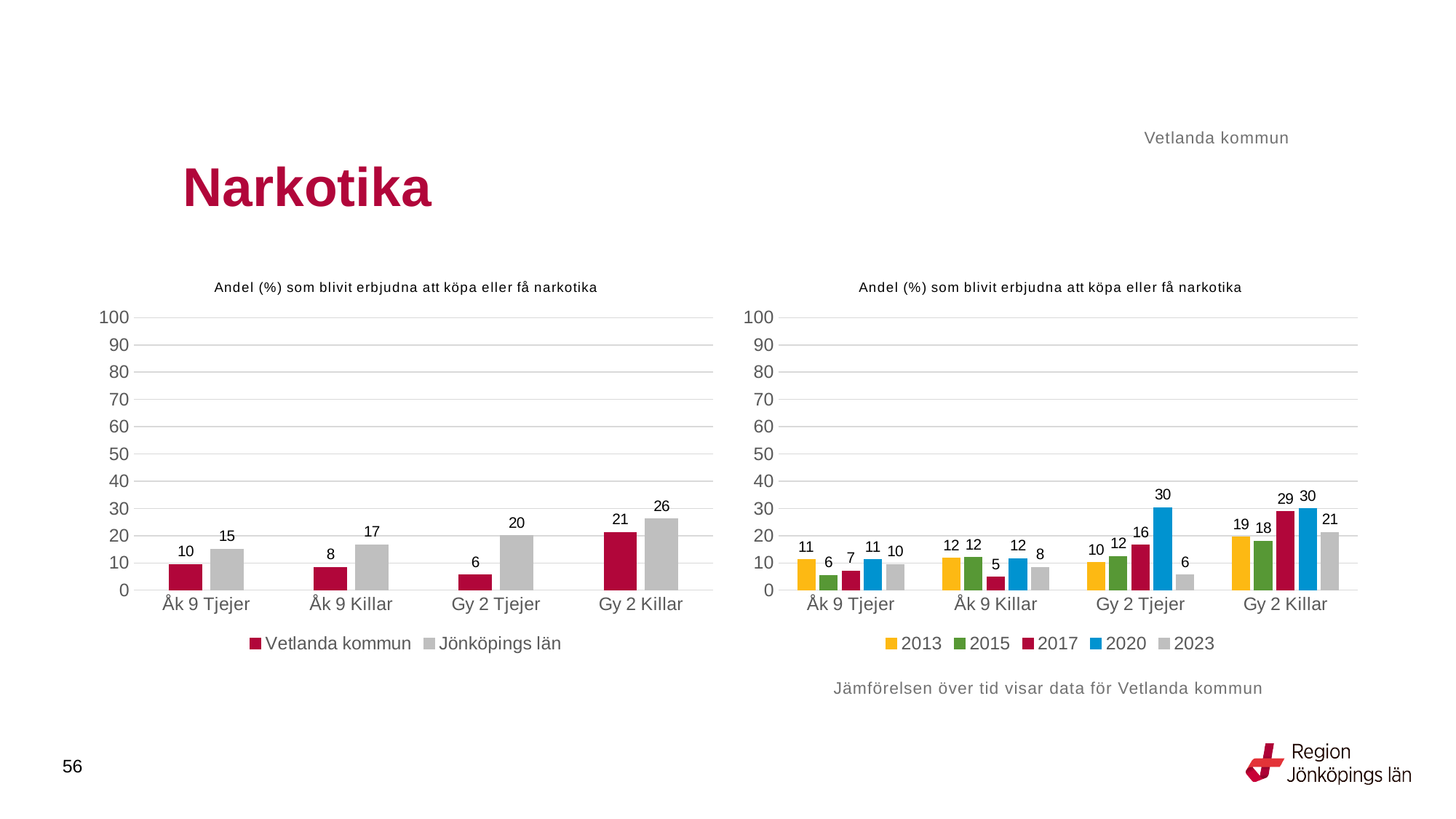
In the left chart, what is the value for Vetlanda kommun for Gy 2 Killar? 21 What type of chart is the left chart? Bar chart In the right chart, which year has the highest value for Gy 2 Killar? 2020 In the right chart, how many series does the legend list? 5 In the left chart, what is the value for Jönköpings län for Åk 9 Killar? 17 In the left chart, what is the difference between Jönköpings län and Vetlanda kommun for Gy 2 Tjejer? 14 In the right chart, which is larger for Åk 9 Tjejer: the value for 2013 or the value for 2015? 2013 In the right chart, what is the value for 2020 for Gy 2 Tjejer? 30 In the right chart, what is the value for 2017 for Åk 9 Killar? 5 In the left chart, which category has the lowest value for Vetlanda kommun? Gy 2 Tjejer In the right chart, what is the difference between the 2020 and 2023 values for Gy 2 Tjejer? 24 In the left chart, how many series does the legend list? 2